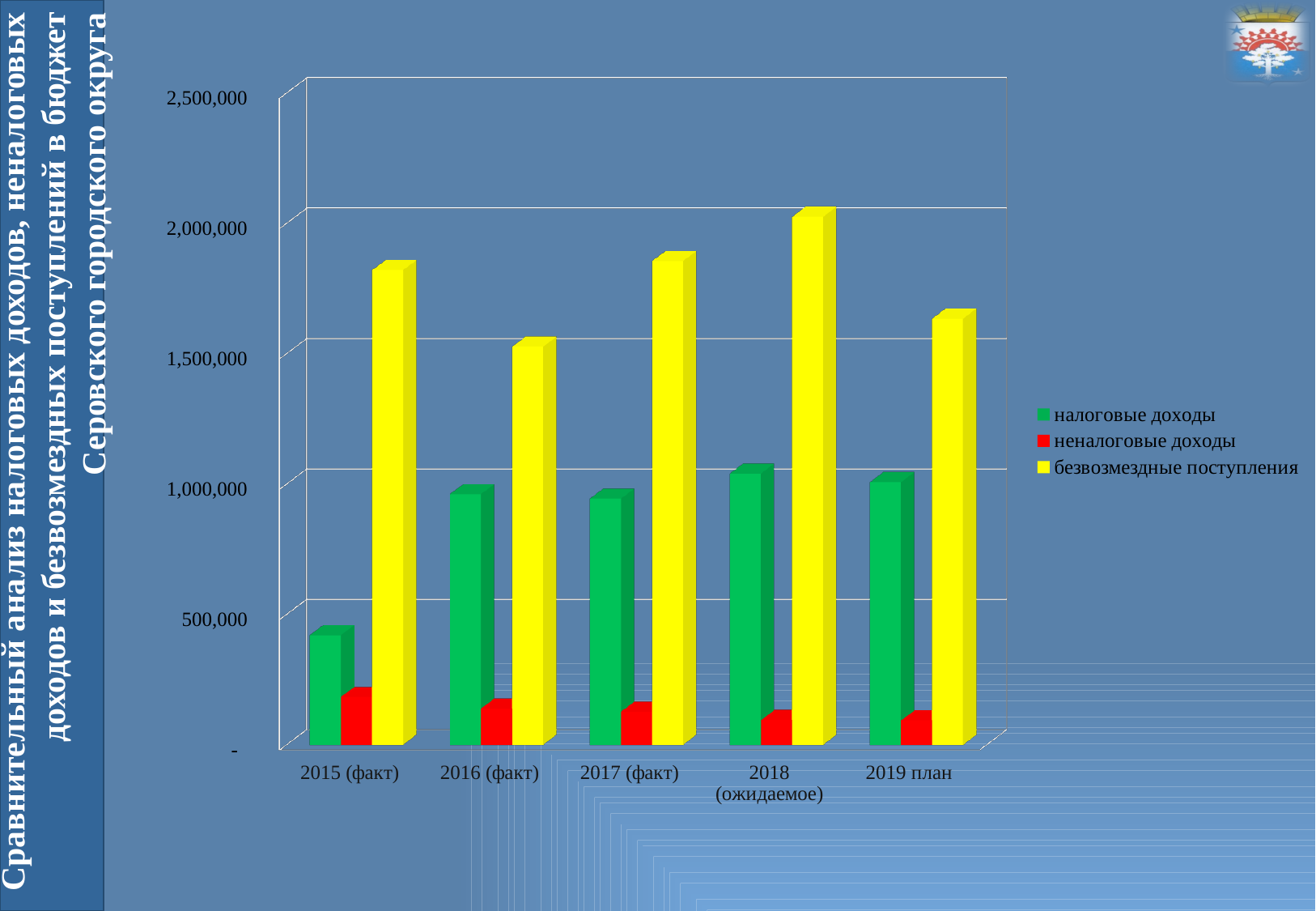
In which year are неналоговые доходы the highest? 2015 (факт) How many categories (years) are shown on the x axis of the chart? 5 How many series does the chart legend list? 3 In which year are безвозмездные поступления the lowest? 2016 (факт) Which is larger in 2015 (факт): налоговые доходы or безвозмездные поступления? безвозмездные поступления Is the value of налоговые доходы for 2015 (факт) greater or less than 500,000? less Do налоговые доходы rise or fall from 2015 (факт) to 2016 (факт)? rise In which year are налоговые доходы the lowest? 2015 (факт) What kind of chart is shown on the slide? bar chart In which year are безвозмездные поступления the highest? 2018 (ожидаемое) Is the value of безвозмездные поступления for 2019 план greater or less than 2,000,000? less Which series is shown in yellow in the chart? безвозмездные поступления